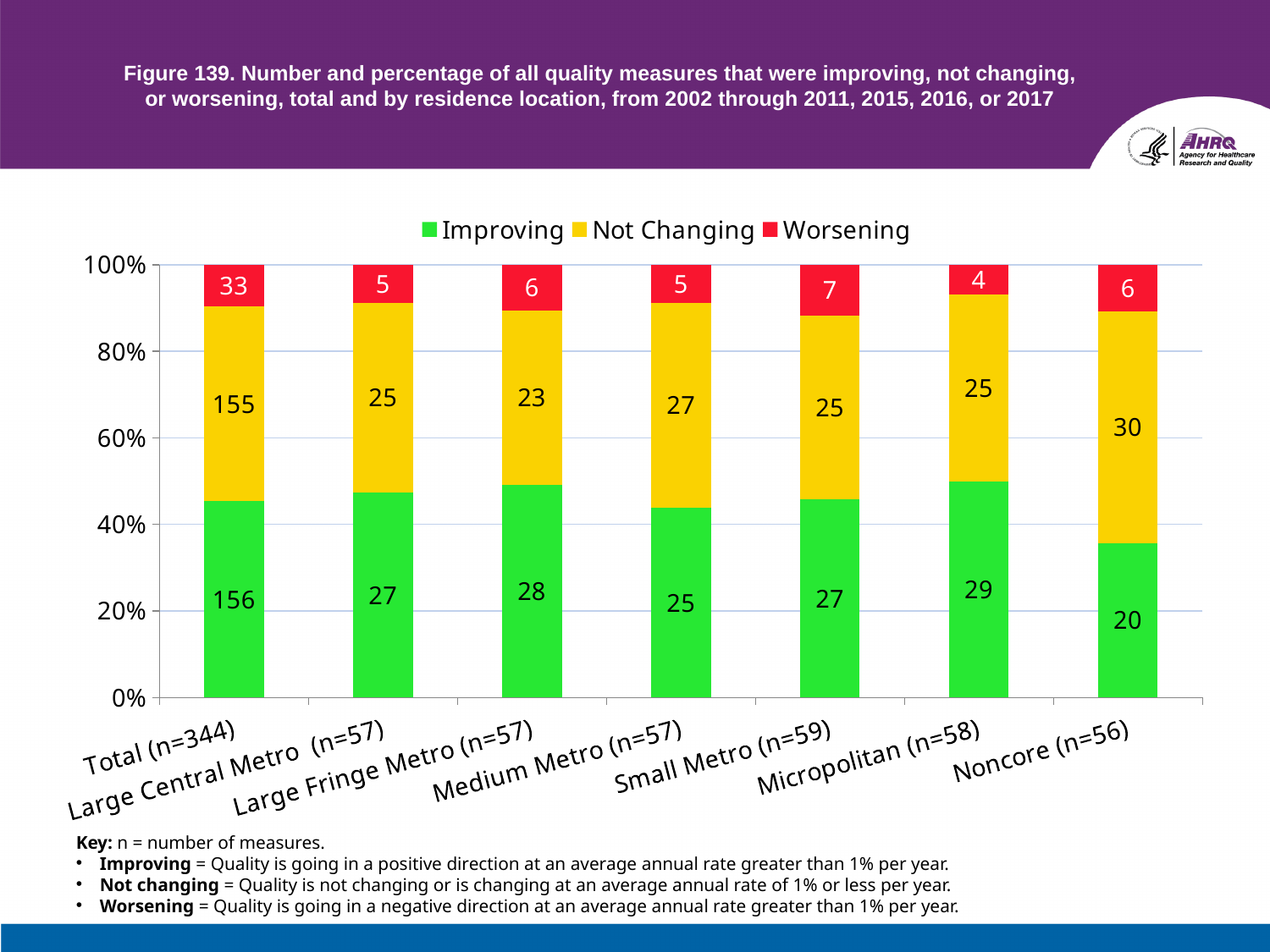
How many measures were worsening for Micropolitan (n=58)? 4 What is the total number of measures in the Large Central Metro bar (sum of improving, not changing, and worsening)? 57 What kind of chart is shown on the slide? Stacked bar chart Is the improving share of the Noncore (n=56) bar greater or less than 40%? less Which residence location has the lowest number of improving measures? Noncore (n=56) How many measures were improving in the Total (n=344) bar? 156 How many residence location categories (including Total) are shown on the x axis? 7 Among the residence locations (excluding Total), which has the highest number of worsening measures? Small Metro (n=59) What is the difference between the number of improving and worsening measures for Large Fringe Metro (n=57)? 22 How many measures were not changing for Noncore (n=56)? 30 How many series does the legend list? 3 Which is larger for Medium Metro (n=57): the number of improving measures or the number of not changing measures? Not changing